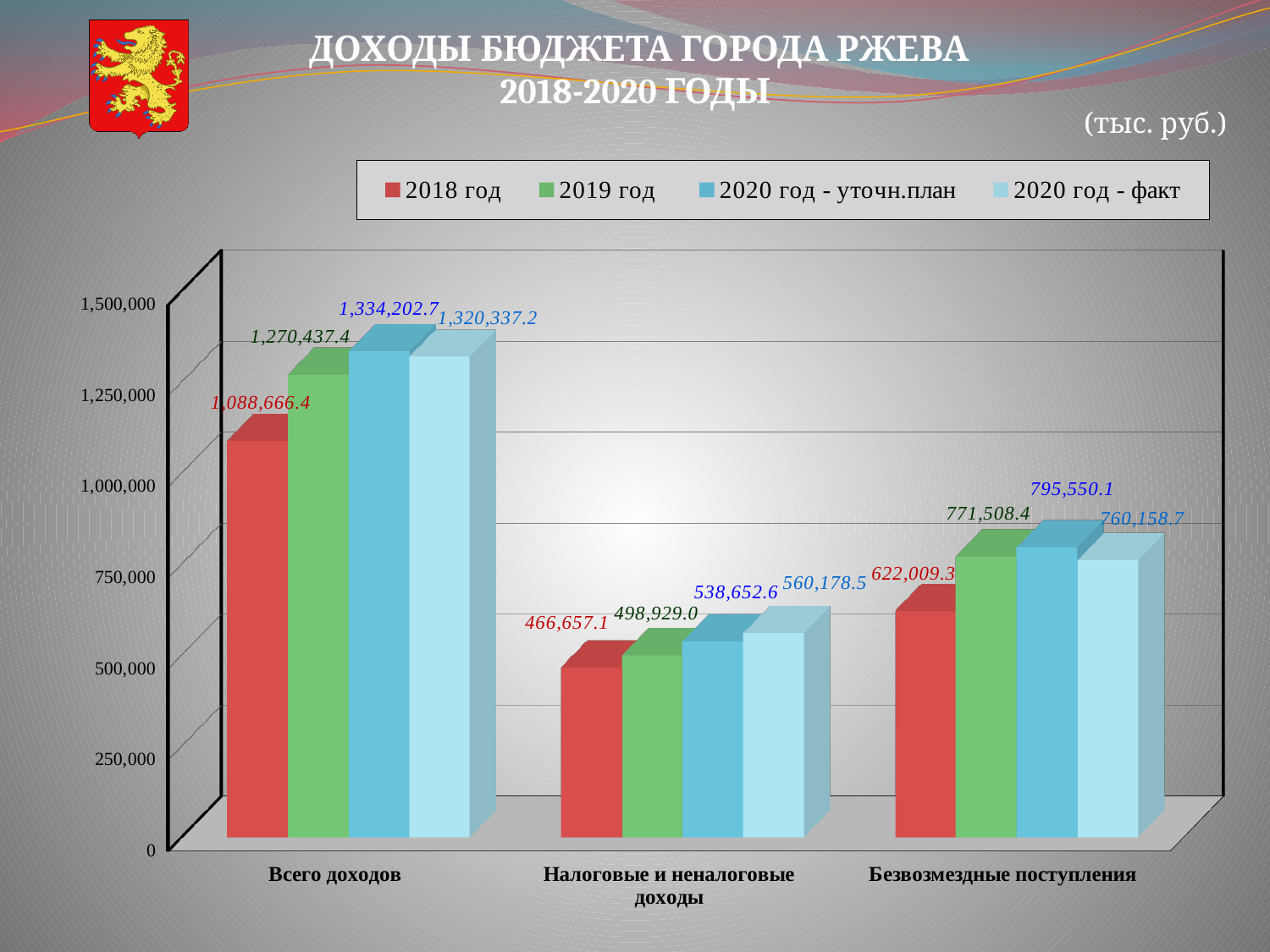
Is the 2018 год value for Безвозмездные поступления greater or less than 750,000? less What is the value for 2018 год in the Всего доходов category? 1,088,666.4 What is the difference between the 2020 год - факт and 2018 год values in the Всего доходов category? 231,670.8 What kind of chart is shown on the slide? bar chart In the Безвозмездные поступления category, which is larger: the 2020 год - уточн.план value or the 2020 год - факт value? 2020 год - уточн.план Which series has the lowest value in the Налоговые и неналоговые доходы category? 2018 год How many series does the legend list? 4 What is the value for 2020 год - факт in the Налоговые и неналоговые доходы category? 560,178.5 What is the value for 2019 год in the Безвозмездные поступления category? 771,508.4 How many categories are shown on the x axis? 3 What is the difference between the 2019 год and 2018 год values in the Безвозмездные поступления category? 149,499.1 Which series has the highest value in the Всего доходов category? 2020 год - уточн.план